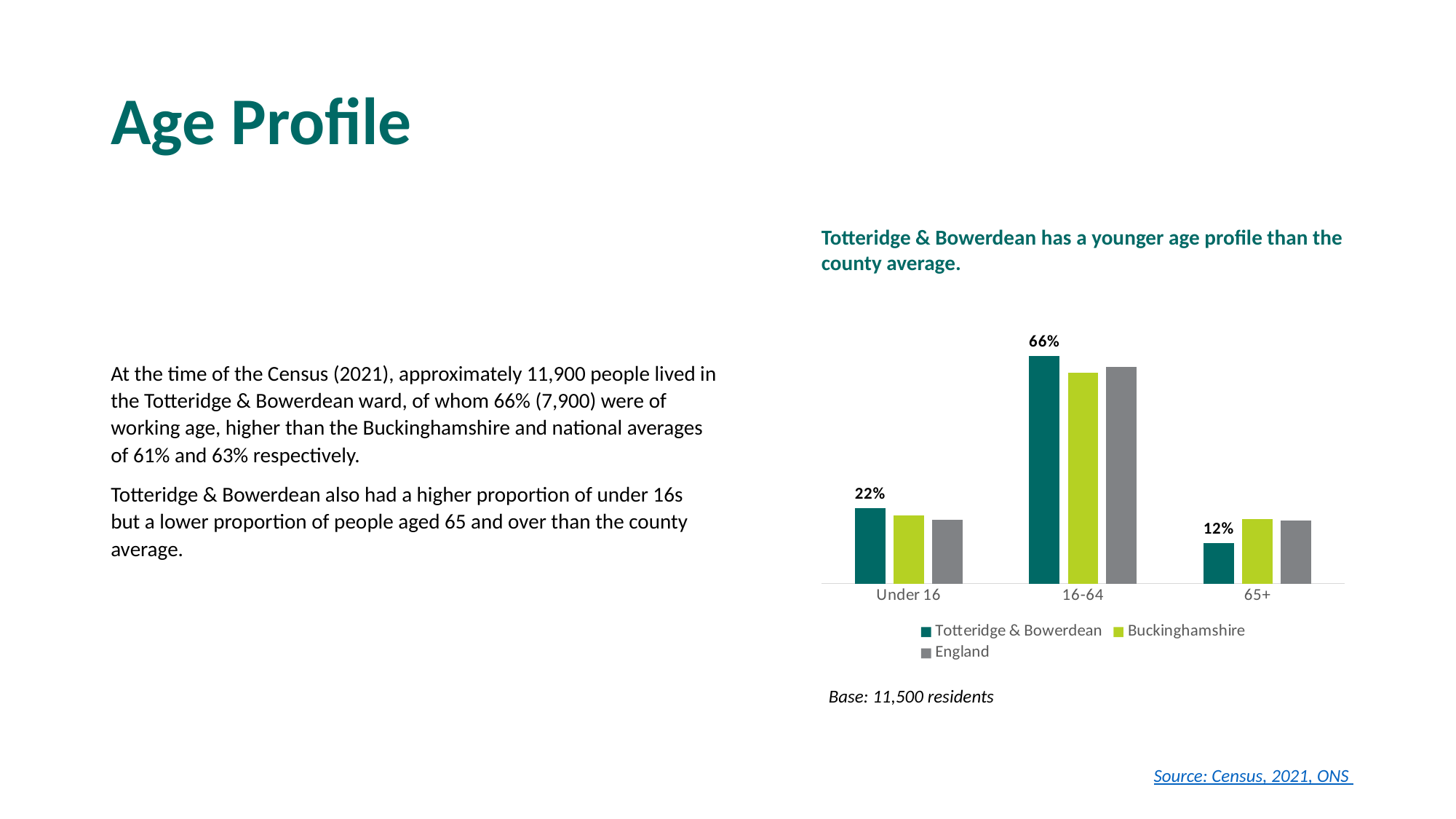
How many series does the legend list? 3 What is the value for Totteridge & Bowerdean in the 65+ age group? 12% What is the value for Totteridge & Bowerdean in the Under 16 age group? 22% What is the difference between the Totteridge & Bowerdean values for 16-64 and Under 16? 44 percentage points Which age group has the highest value for Totteridge & Bowerdean? 16-64 How many age group categories are shown on the x axis? 3 What is the difference between the Totteridge & Bowerdean values for Under 16 and 65+? 10 percentage points What is the value for Totteridge & Bowerdean in the 16-64 age group? 66% What kind of chart is shown on the slide? bar chart Which age group has the lowest value for Totteridge & Bowerdean? 65+ In the Under 16 age group, which is larger: Totteridge & Bowerdean or England? Totteridge & Bowerdean In the 65+ age group, which is larger: Totteridge & Bowerdean or Buckinghamshire? Buckinghamshire